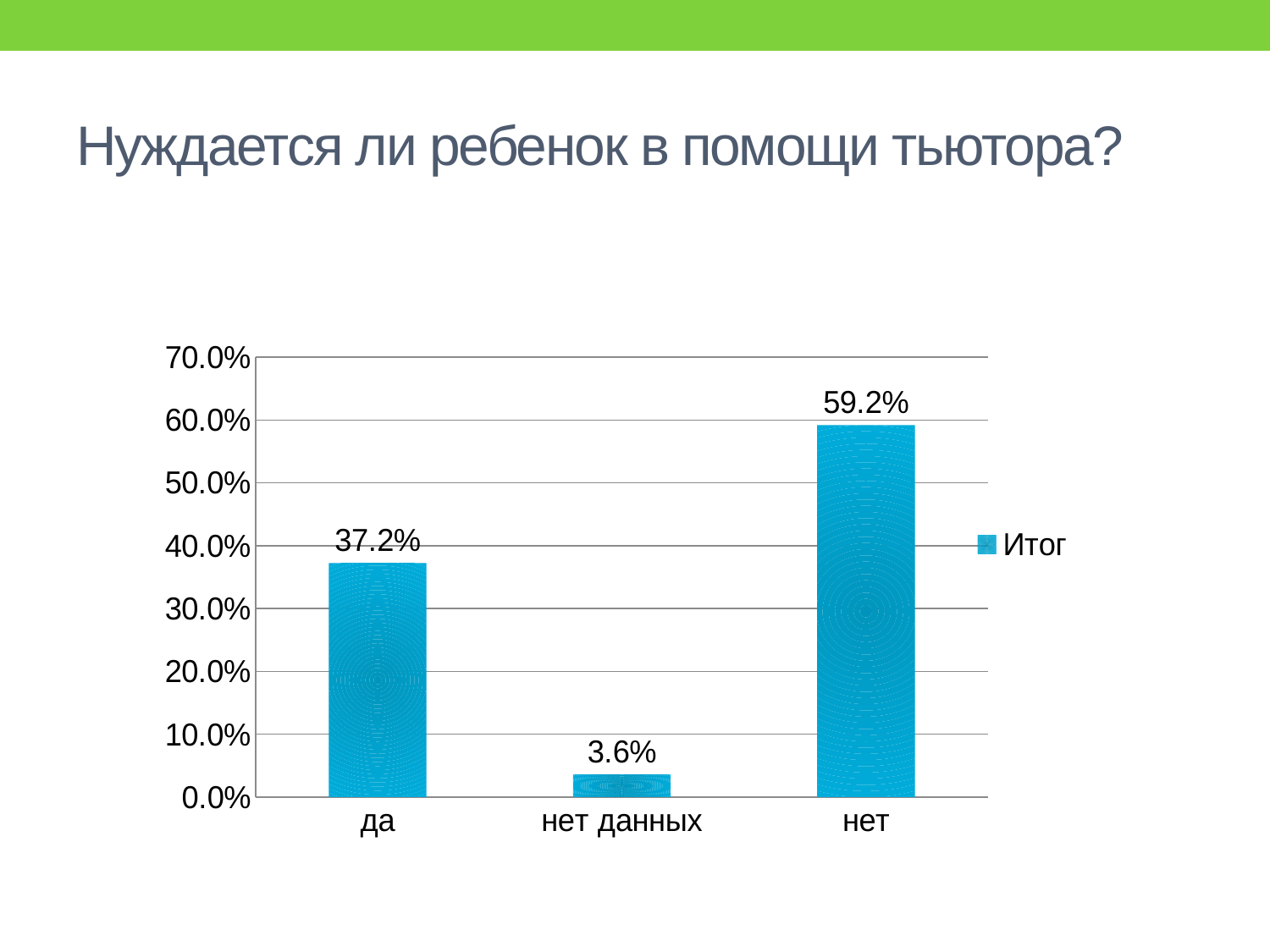
Is the value for "да" greater or less than 40.0%? less Which is larger, the value for "да" or the value for "нет"? нет What is the value for "нет"? 59.2% What is the difference between the values for "да" and "нет данных"? 33.6% How many categories are shown on the x axis? 3 What series name does the legend show? Итог What is the difference between the values for "нет" and "да"? 22.0% What is the value for "да"? 37.2% What is the value for "нет данных"? 3.6% What kind of chart is shown on the slide? bar chart Which category has the highest value? нет Which category has the lowest value? нет данных